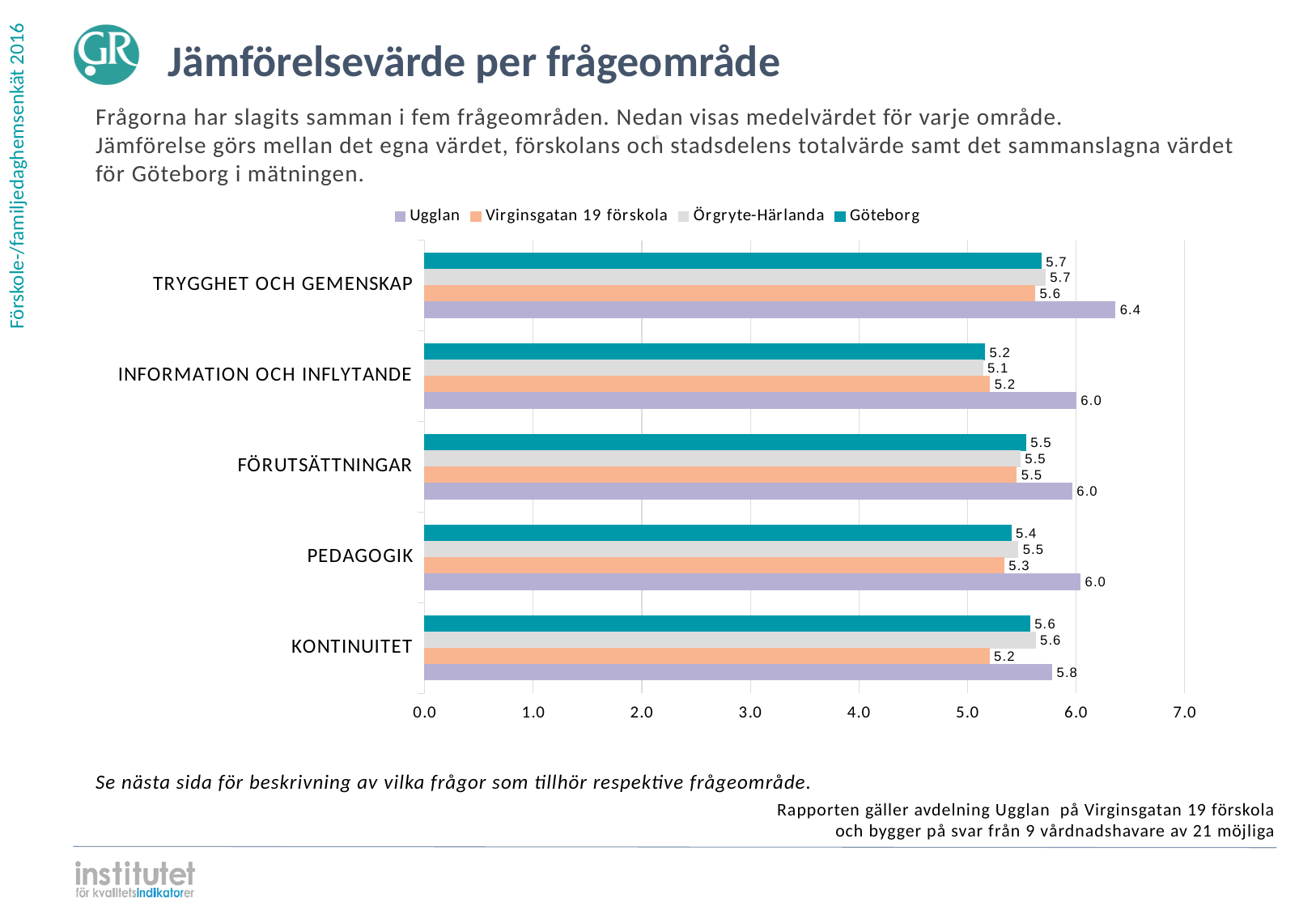
What is the value for Virginsgatan 19 förskola in KONTINUITET? 5.2 What is the difference between Ugglan and Göteborg in INFORMATION OCH INFLYTANDE? 0.8 What kind of chart is shown on the slide? bar chart How many series does the legend list? 4 Which is larger in PEDAGOGIK: the value for Örgryte-Härlanda or the value for Virginsgatan 19 förskola? Örgryte-Härlanda How many question areas (categories) are shown on the chart? 5 What is the value for Örgryte-Härlanda in INFORMATION OCH INFLYTANDE? 5.1 In which question area does Ugglan have its highest value? TRYGGHET OCH GEMENSKAP What is the value for Ugglan in TRYGGHET OCH GEMENSKAP? 6.4 Which series is shown in purple in the legend? Ugglan In which question area does Ugglan have its lowest value? KONTINUITET What is the value for Göteborg in PEDAGOGIK? 5.4